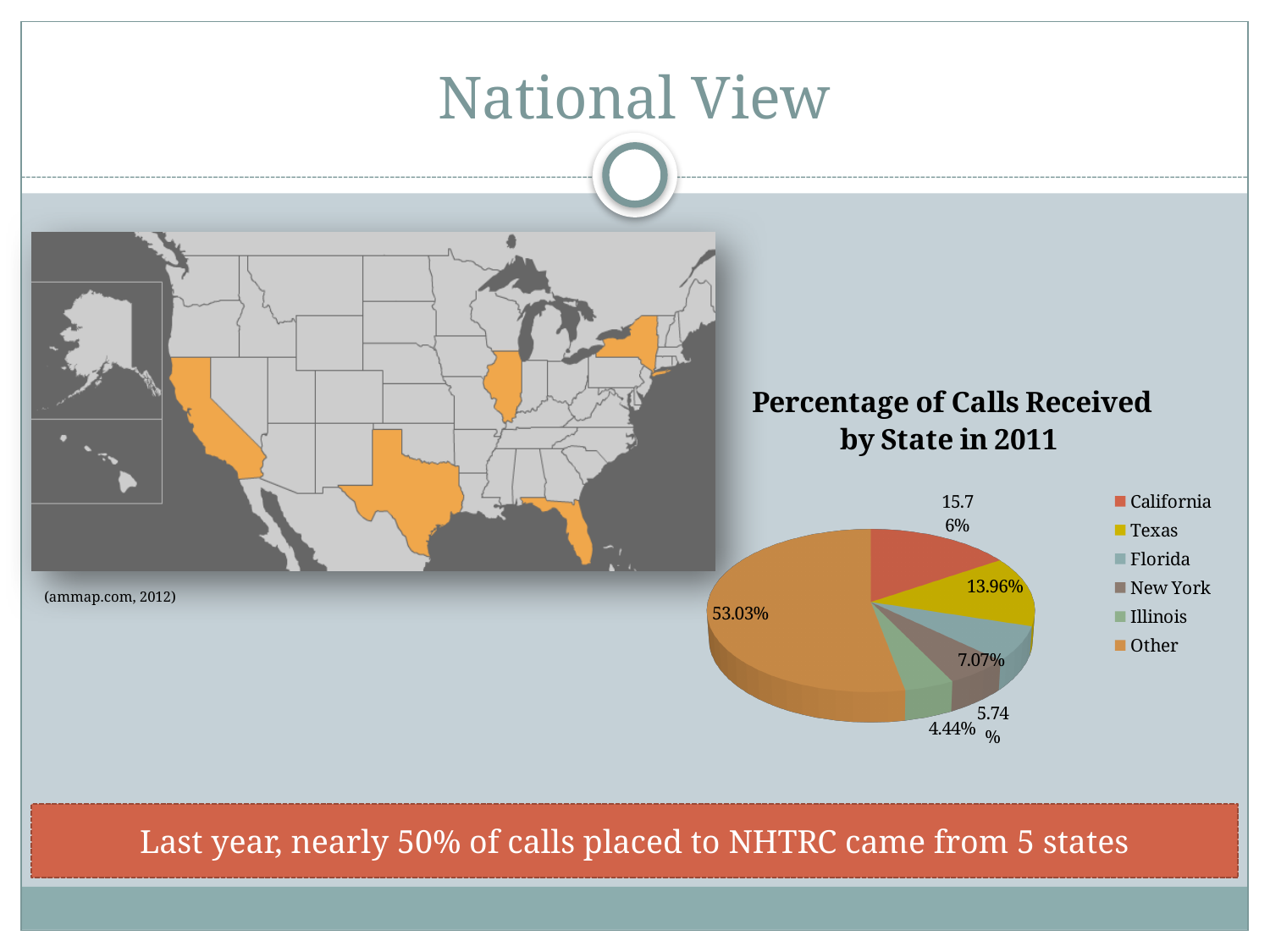
Which category has the largest slice in the pie chart? Other Which state has the smallest slice in the pie chart? Illinois What is the title of the chart on the slide? Percentage of Calls Received by State in 2011 What percentage of calls came from Texas according to the pie chart? 13.96% What percentage of calls came from Florida according to the pie chart? 7.07% What percentage of calls came from Illinois according to the pie chart? 4.44% How many entries does the legend of the pie chart list? 6 What percentage of calls came from California according to the pie chart? 15.76% Which has a larger share in the pie chart, Florida or New York? Florida What is the difference between the California and Texas percentages in the pie chart? 1.8% What type of chart is shown on the slide? pie chart What percentage of calls came from New York according to the pie chart? 5.74%